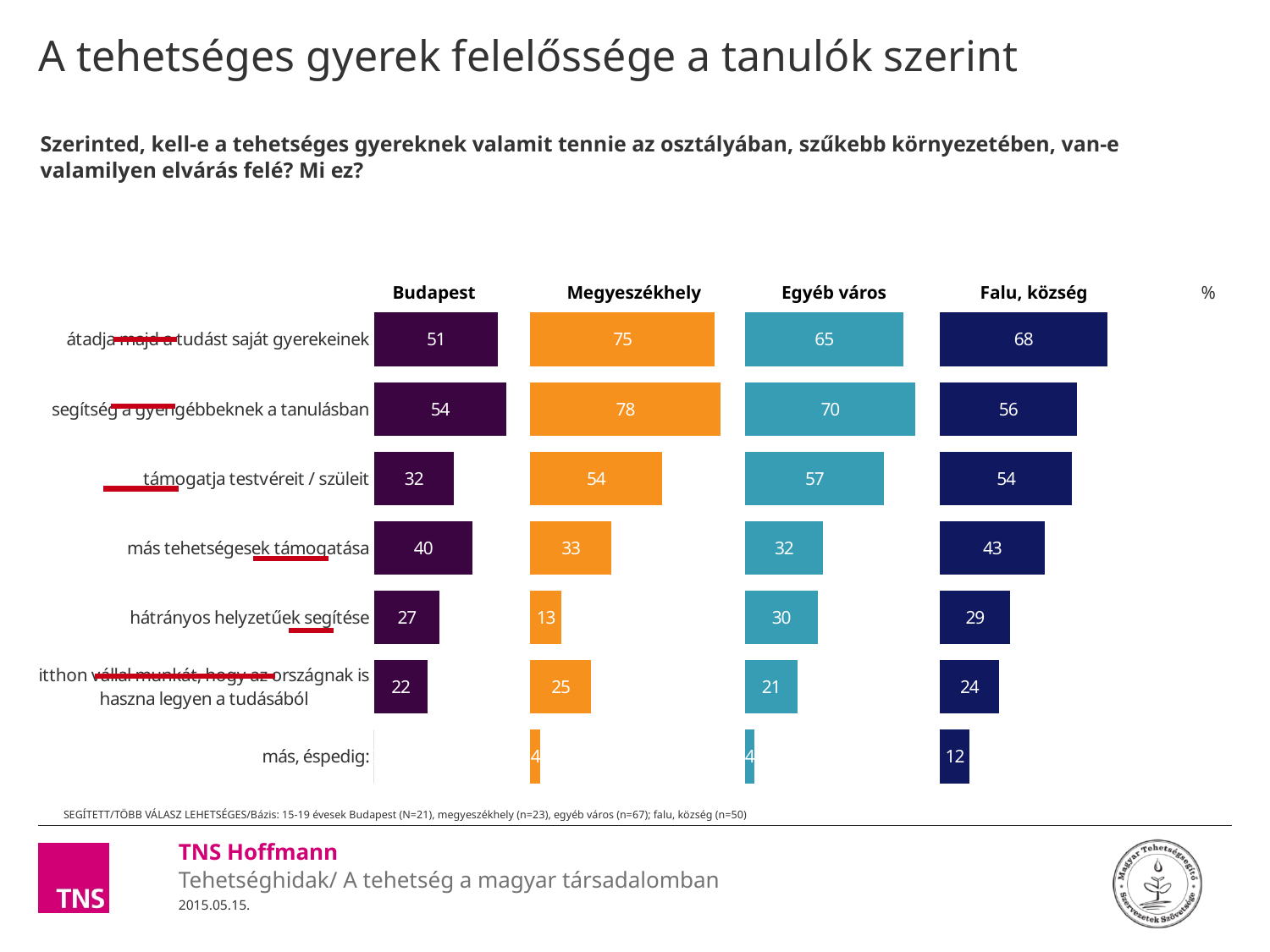
In the Falu, község chart, which category has the highest value? átadja majd a tudást saját gyerekeinek In the Egyéb város chart, what is the difference between 'segítség a gyengébbeknek a tanulásban' and 'hátrányos helyzetűek segítése'? 40 What type of chart is used on this slide? Bar chart How many category rows are listed on the left of the charts? 7 In the Budapest chart, which category has the lowest value among those with a bar shown? itthon vállal munkát, hogy az országnak is haszna legyen a tudásából Which is larger: the Budapest value or the Falu, község value for 'más tehetségesek támogatása'? Falu, község In the Falu, község chart, what is the value for 'más, éspedig:'? 12 In the Megyeszékhely chart, which category has the highest value? segítség a gyengébbeknek a tanulásban In the Egyéb város chart, what is the value for 'támogatja testvéreit / szüleit'? 57 In the Budapest chart, what is the value for 'segítség a gyengébbeknek a tanulásban'? 54 In the Megyeszékhely chart, what is the difference between 'támogatja testvéreit / szüleit' and 'hátrányos helyzetűek segítése'? 41 In the Megyeszékhely chart, what is the value for 'átadja majd a tudást saját gyerekeinek'? 75